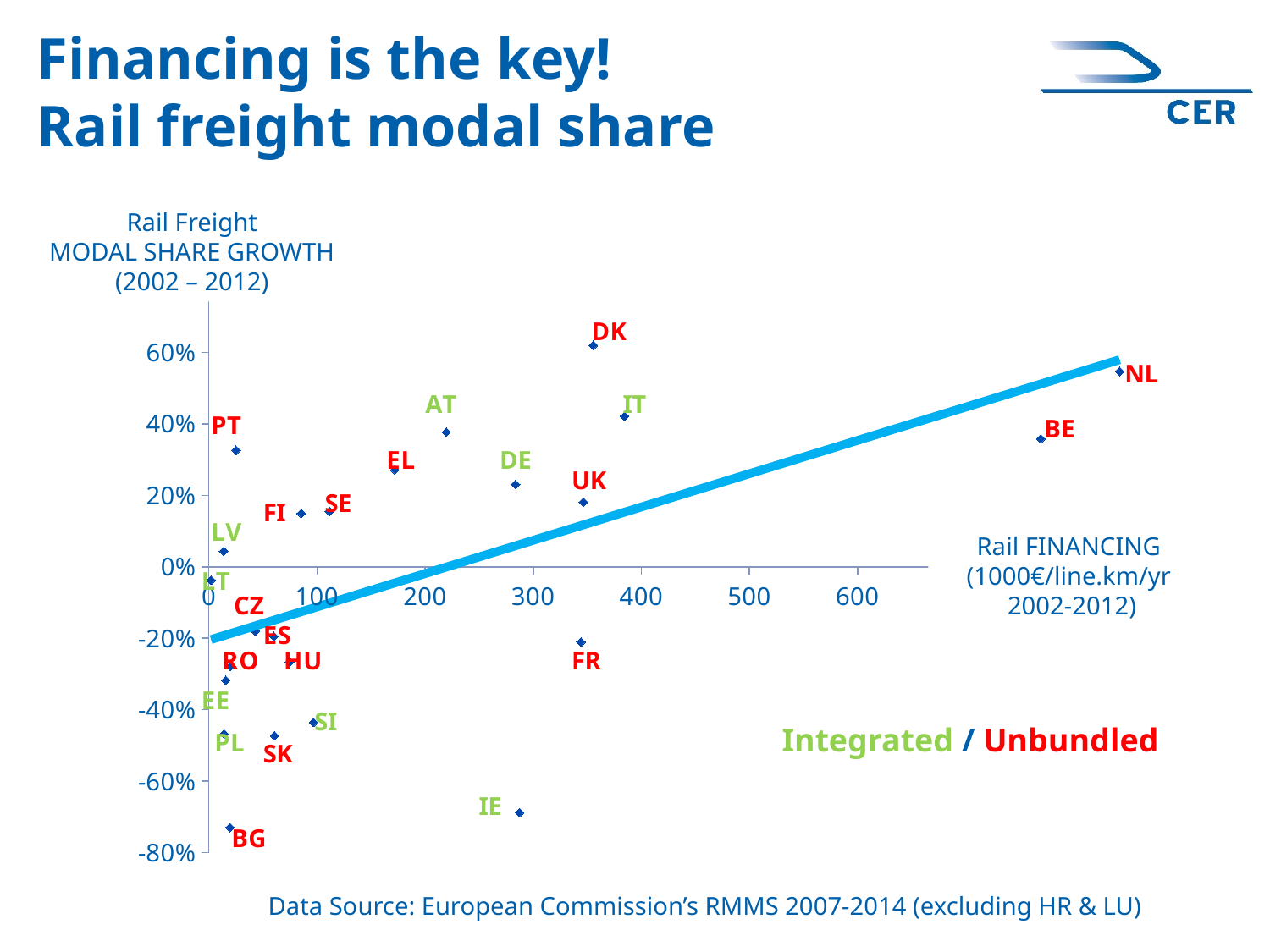
Is the rail freight modal share growth for FR greater or less than 0%? less Is the rail financing value for NL greater or less than 600? greater What kind of chart is shown on the slide? scatter chart Which has the higher rail freight modal share growth, DK or NL? DK Is the rail freight modal share growth for IE greater or less than -60%? less What colour are the labels of the Integrated countries on the chart? green Which has the higher rail financing value, NL or BE? NL Which country has the highest rail freight modal share growth on the chart? DK According to the trend line, does rail freight modal share growth rise or fall as rail financing increases? rise Which country has the highest rail financing value (furthest right on the x axis)? NL Which country has the lowest rail freight modal share growth on the chart? BG